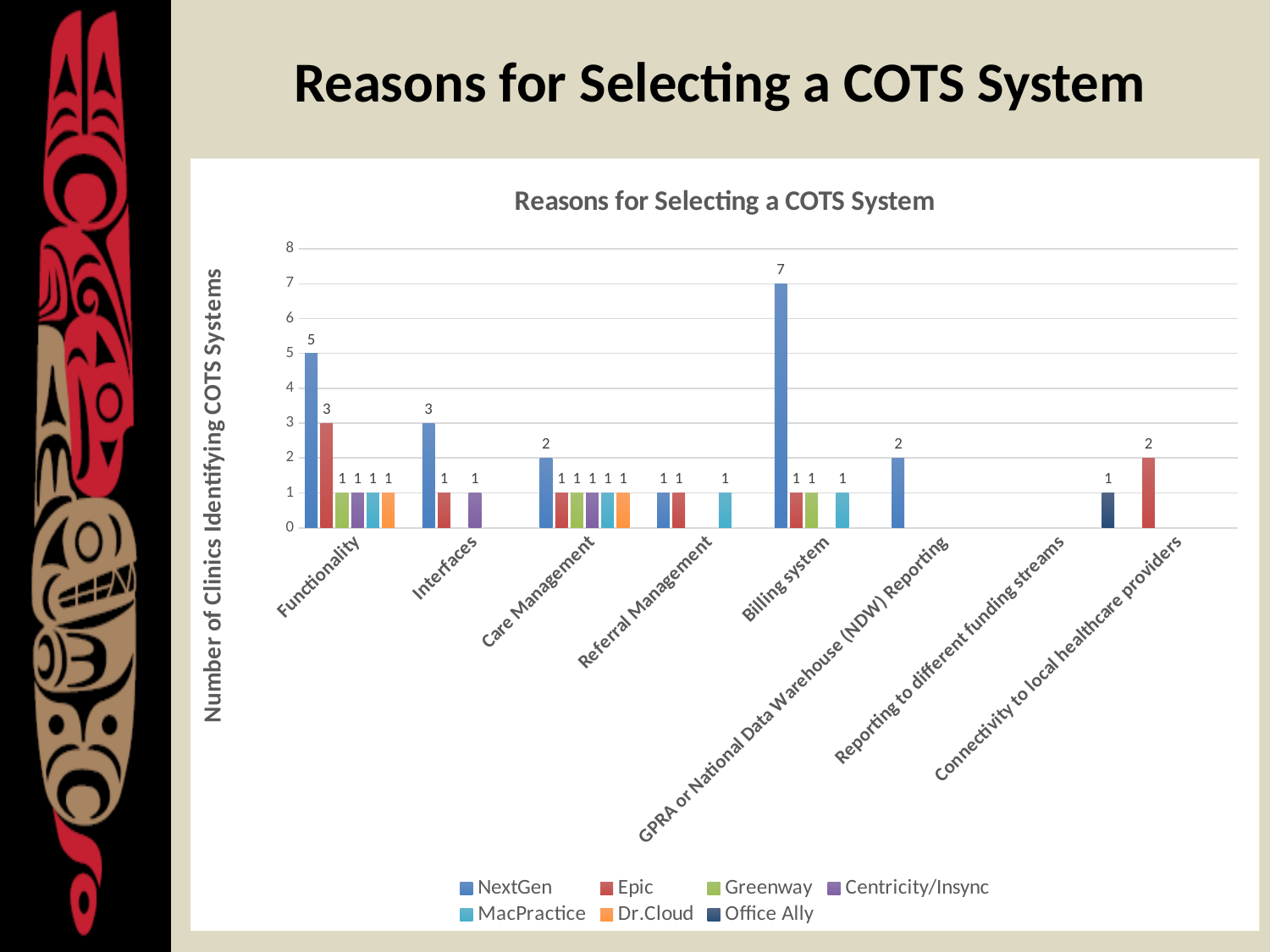
What is the difference between the NextGen value for Billing system and the NextGen value for Functionality? 2 How many series does the legend list? 7 What kind of chart is shown on the slide? Bar chart What is the value for Epic in the Connectivity to local healthcare providers category? 2 How many categories are shown on the x axis? 8 What is the value for Epic in the Functionality category? 3 What is the difference between the NextGen and Epic values in the Functionality category? 2 In which category does NextGen have its highest value? Billing system Which is larger, the NextGen value for Interfaces or the NextGen value for Care Management? Interfaces What is the value for NextGen in the Billing system category? 7 What is the value for NextGen in the GPRA or National Data Warehouse (NDW) Reporting category? 2